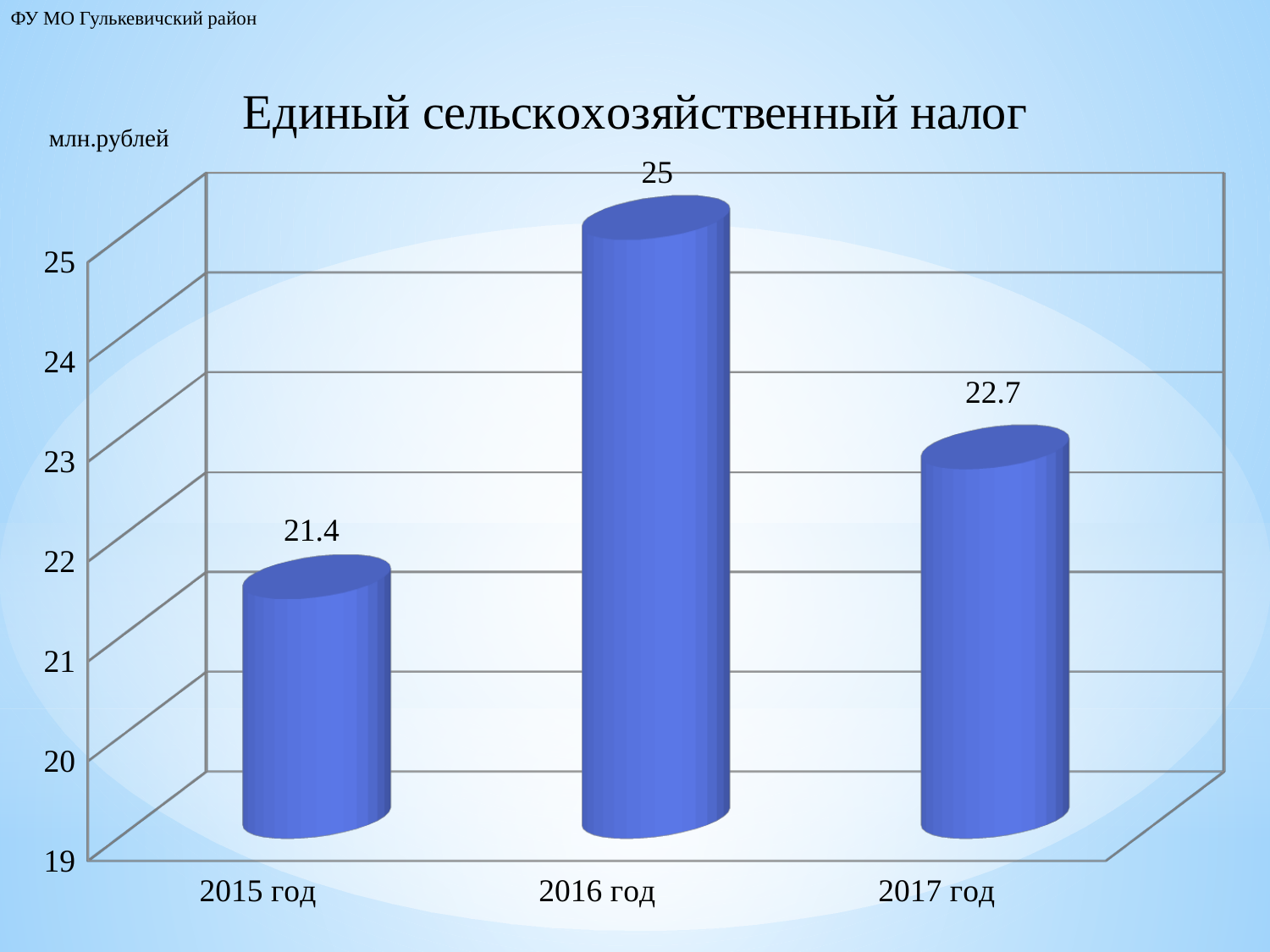
What is the value for 2017 год? 22.7 What is the title of the chart? Единый сельскохозяйственный налог What is the value for 2015 год? 21.4 What is the difference between the values for 2016 год and 2015 год? 3.6 What is the difference between the values for 2017 год and 2015 год? 1.3 What is the value for 2016 год? 25 How many categories are shown on the chart? 3 What kind of chart is shown on the slide? bar chart Which is larger, the value for 2017 год or the value for 2015 год? 2017 год Which year has the highest value? 2016 год Which year has the lowest value? 2015 год What unit is shown for the values on the chart? млн.рублей